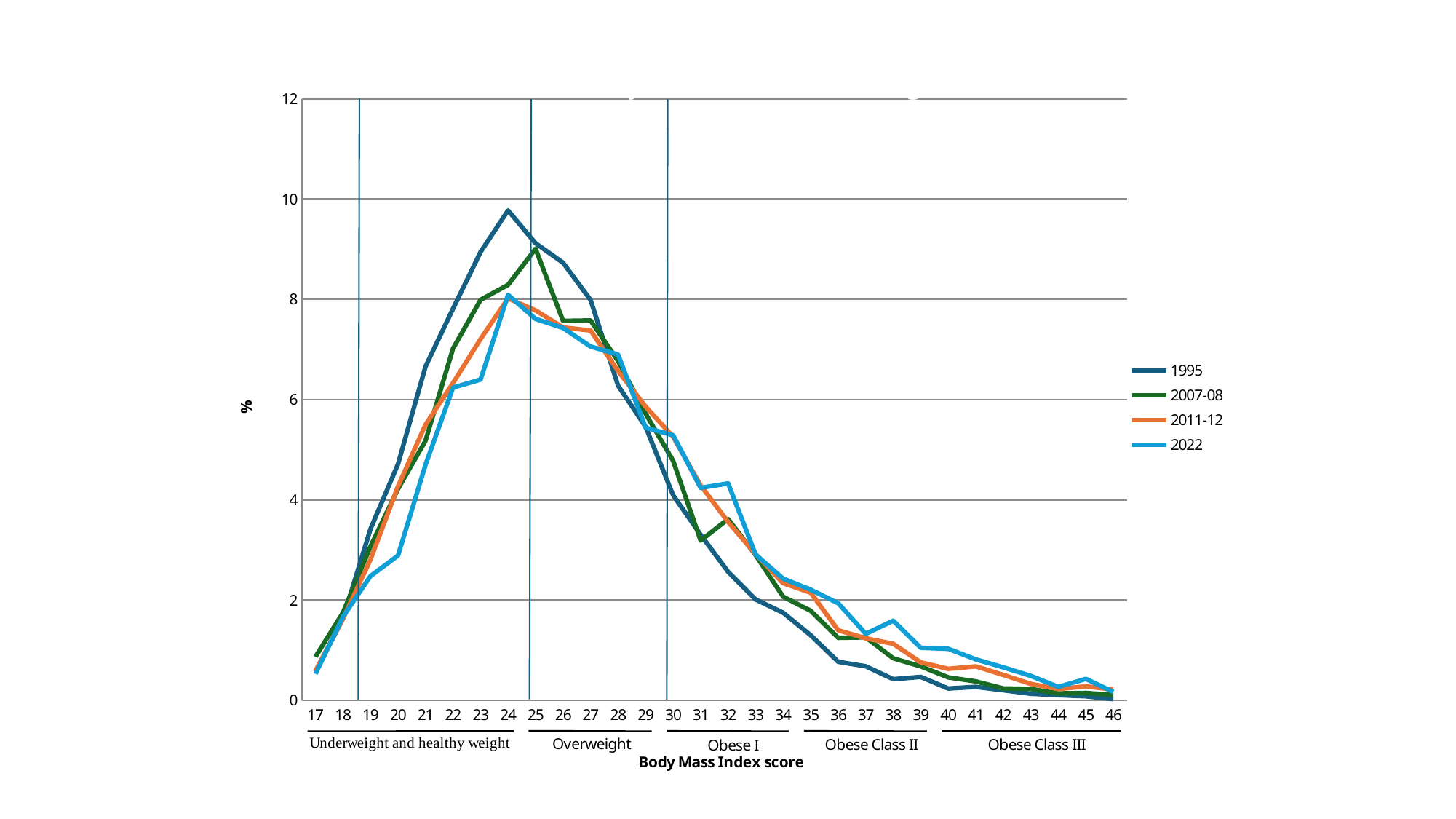
Is the value for the 1995 series at a Body Mass Index score of 24 greater or less than 8? greater At which Body Mass Index score does the 2007-08 series reach its highest value? 25 What is the title of the x axis? Body Mass Index score Is the value for the 2022 series at a Body Mass Index score of 20 greater or less than 4? less Do the values of the 1995 series rise or fall as the Body Mass Index score increases from 30 to 46? fall How many series does the legend list? 4 At a Body Mass Index score of 24, which series has the larger value, 1995 or 2022? 1995 How many Body Mass Index scores are shown along the x axis? 30 At a Body Mass Index score of 38, which series has the larger value, 2022 or 1995? 2022 At which Body Mass Index score does the 1995 series reach its highest value? 24 Is the value for the 2007-08 series at a Body Mass Index score of 31 greater or less than 4? less What kind of chart is shown on the slide? line chart